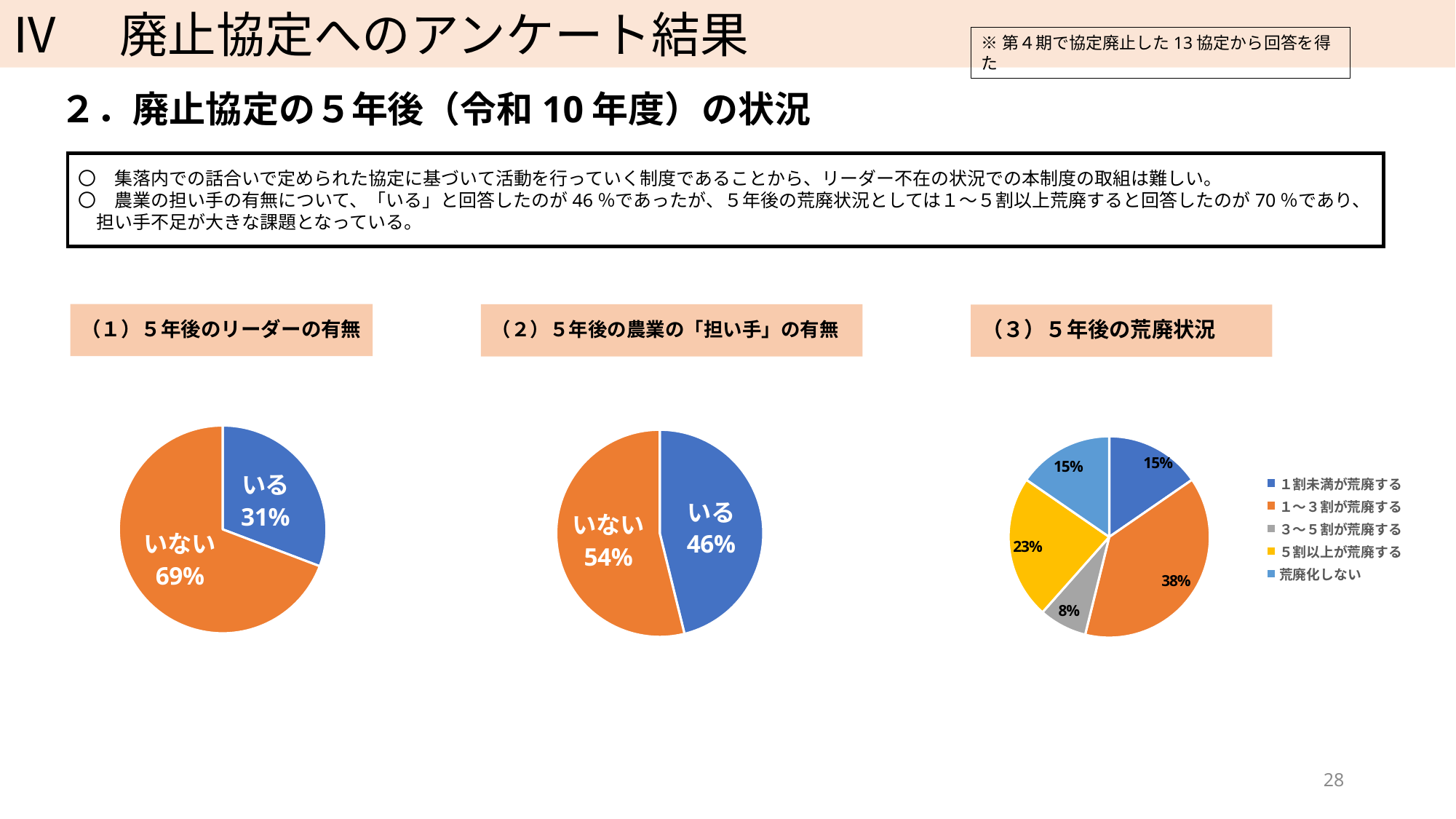
In the chart titled （3）5年後の荒廃状況, how many categories does the legend list? 5 In the chart titled （3）5年後の荒廃状況, which category has the largest share? 1〜3割が荒廃する In the chart titled （3）5年後の荒廃状況, what share is 1〜3割が荒廃する? 38% In the chart titled （3）5年後の荒廃状況, which category has the smallest share? 3〜5割が荒廃する In the chart titled （1）5年後のリーダーの有無, what share of responses is いる? 31% In the chart titled （3）5年後の荒廃状況, what share is 3〜5割が荒廃する? 8% What type of chart is used for （3）5年後の荒廃状況? Pie chart In the chart titled （2）5年後の農業の「担い手」の有無, which category is larger, いる or いない? いない In the chart titled （2）5年後の農業の「担い手」の有無, what share of responses is いる? 46% In the chart titled （1）5年後のリーダーの有無, what is the difference in percentage points between いない and いる? 38 In the chart titled （1）5年後のリーダーの有無, what share of responses is いない? 69% In the chart titled （3）5年後の荒廃状況, what share is 5割以上が荒廃する? 23%